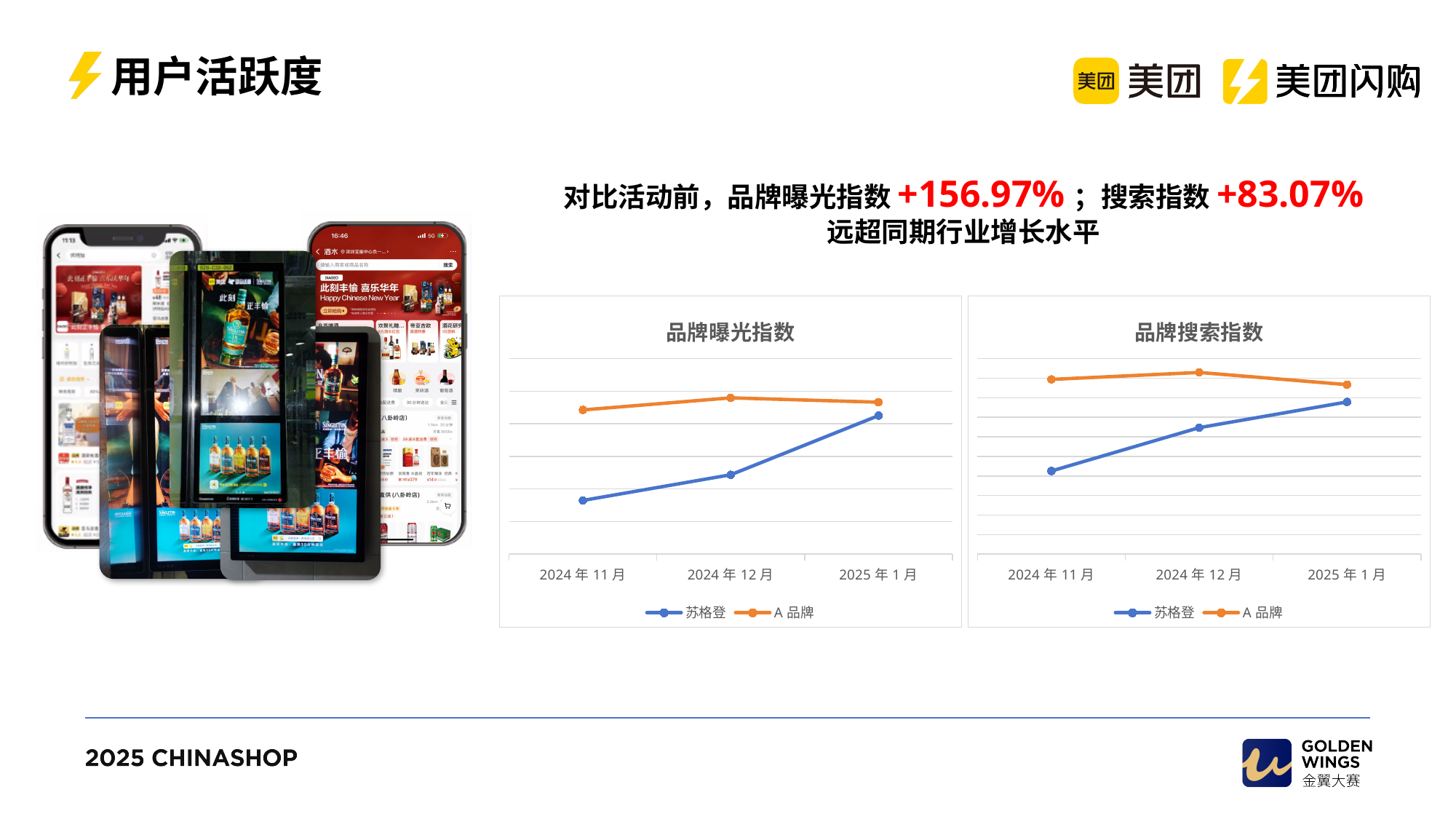
In the 品牌搜索指数 chart, which series has the lower value in 2024 年 12 月, 苏格登 or A 品牌? 苏格登 What colour is the A 品牌 line in the 品牌搜索指数 chart? orange What kind of chart is the 品牌搜索指数 chart? line chart How many series does the legend of the 品牌曝光指数 chart list? 2 In the 品牌曝光指数 chart, does the 苏格登 line rise or fall from 2024 年 11 月 to 2025 年 1 月? rise In the 品牌搜索指数 chart, does the 苏格登 line rise or fall from 2024 年 11 月 to 2025 年 1 月? rise In the 品牌曝光指数 chart, which month has the highest value for 苏格登? 2025 年 1 月 In the 品牌搜索指数 chart, which month has the highest value for A 品牌? 2024 年 12 月 In the 品牌曝光指数 chart, which series has the higher value in 2024 年 11 月, 苏格登 or A 品牌? A 品牌 What kind of chart is the 品牌曝光指数 chart? line chart In the 品牌曝光指数 chart, which month has the lowest value for 苏格登? 2024 年 11 月 How many points along the x axis does the 品牌搜索指数 chart have? 3